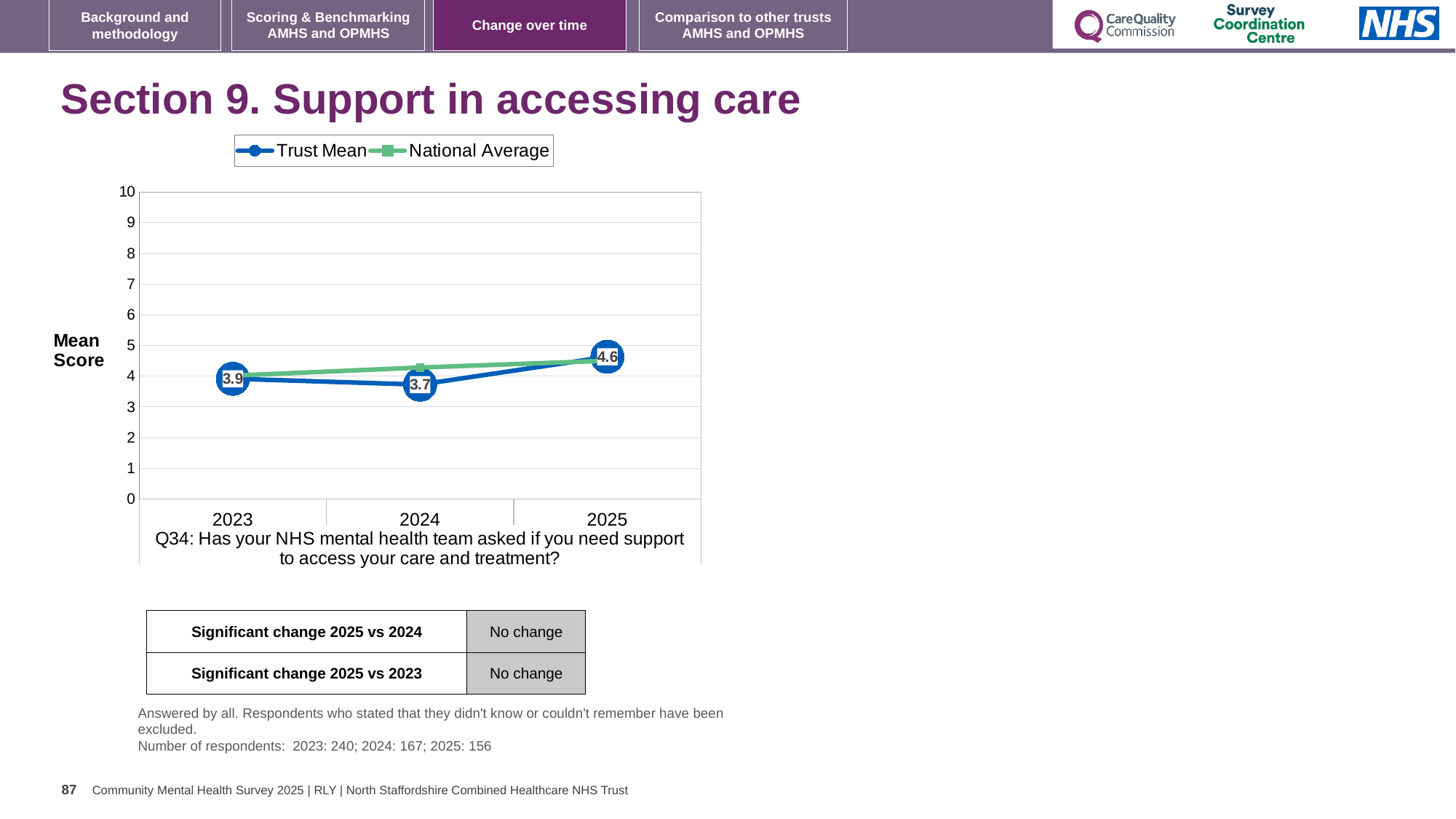
Which is larger, the Trust Mean in 2023 or in 2025? 2025 In which year is the Trust Mean highest? 2025 What is the Trust Mean score for 2024? 3.7 How many years are plotted on the x axis? 3 What kind of chart is shown? line chart What is the Trust Mean score for 2025? 4.6 What is the difference between the Trust Mean in 2025 and in 2024? 0.9 In which year is the Trust Mean lowest? 2024 How many series does the legend list? 2 What is the Trust Mean score for 2023? 3.9 Does the Trust Mean rise or fall from 2024 to 2025? rise Is the National Average value for 2024 greater or less than 5? less